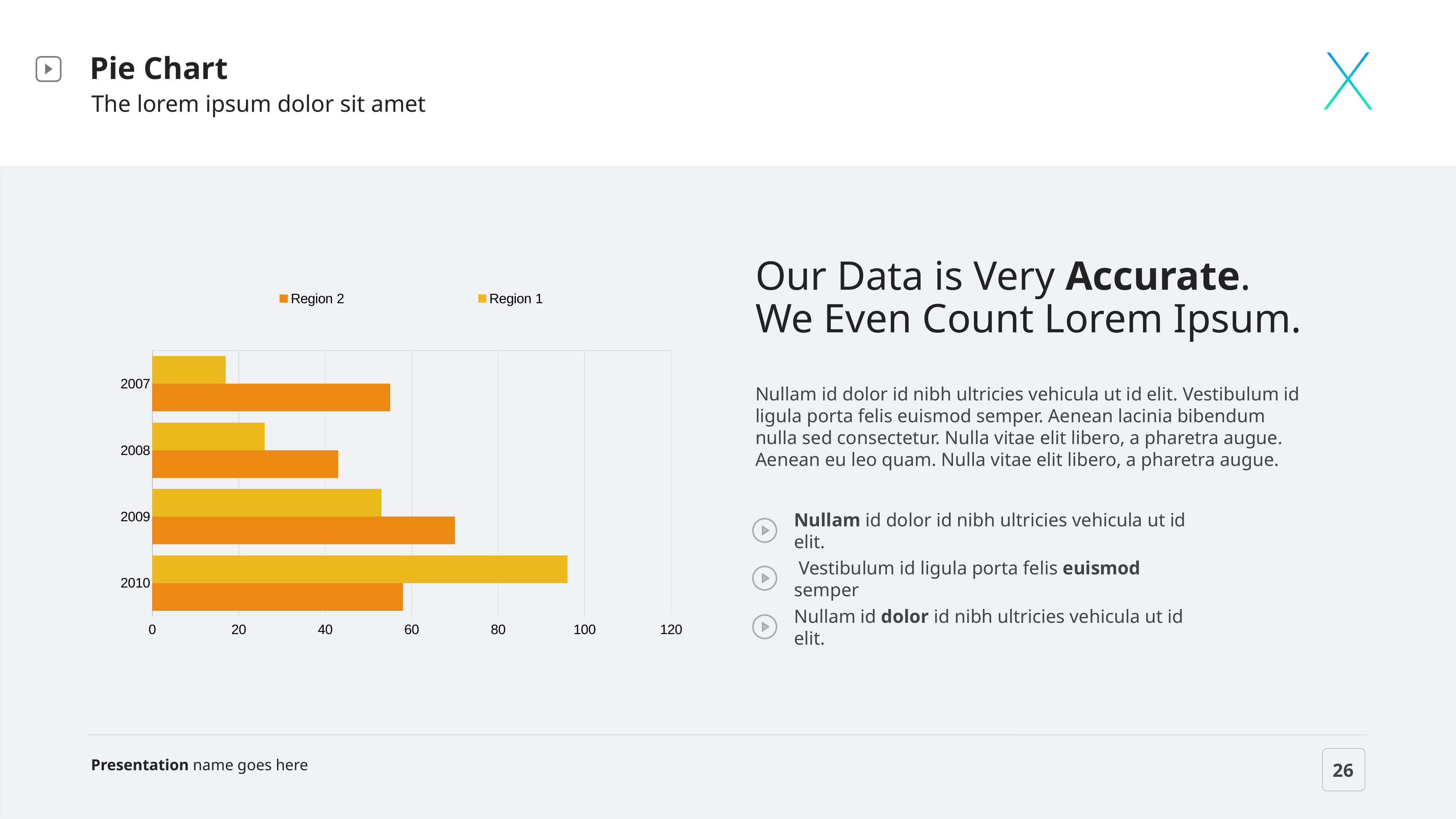
Which year has the highest value for Region 2? 2009 In 2007, which series has the larger value, Region 1 or Region 2? Region 2 In 2010, which series has the larger value, Region 1 or Region 2? Region 1 Which year has the lowest value for Region 2? 2008 What kind of chart is shown on the slide? bar chart Which year has the lowest value for Region 1? 2007 What are the two series names listed in the chart's legend? Region 2 and Region 1 How many series does the chart's legend list? 2 Is the value for Region 1 in 2010 greater or less than 80? greater Which year has the highest value for Region 1? 2010 How many years are shown on the chart's vertical axis? 4 Is the value for Region 1 in 2007 greater or less than 20? less